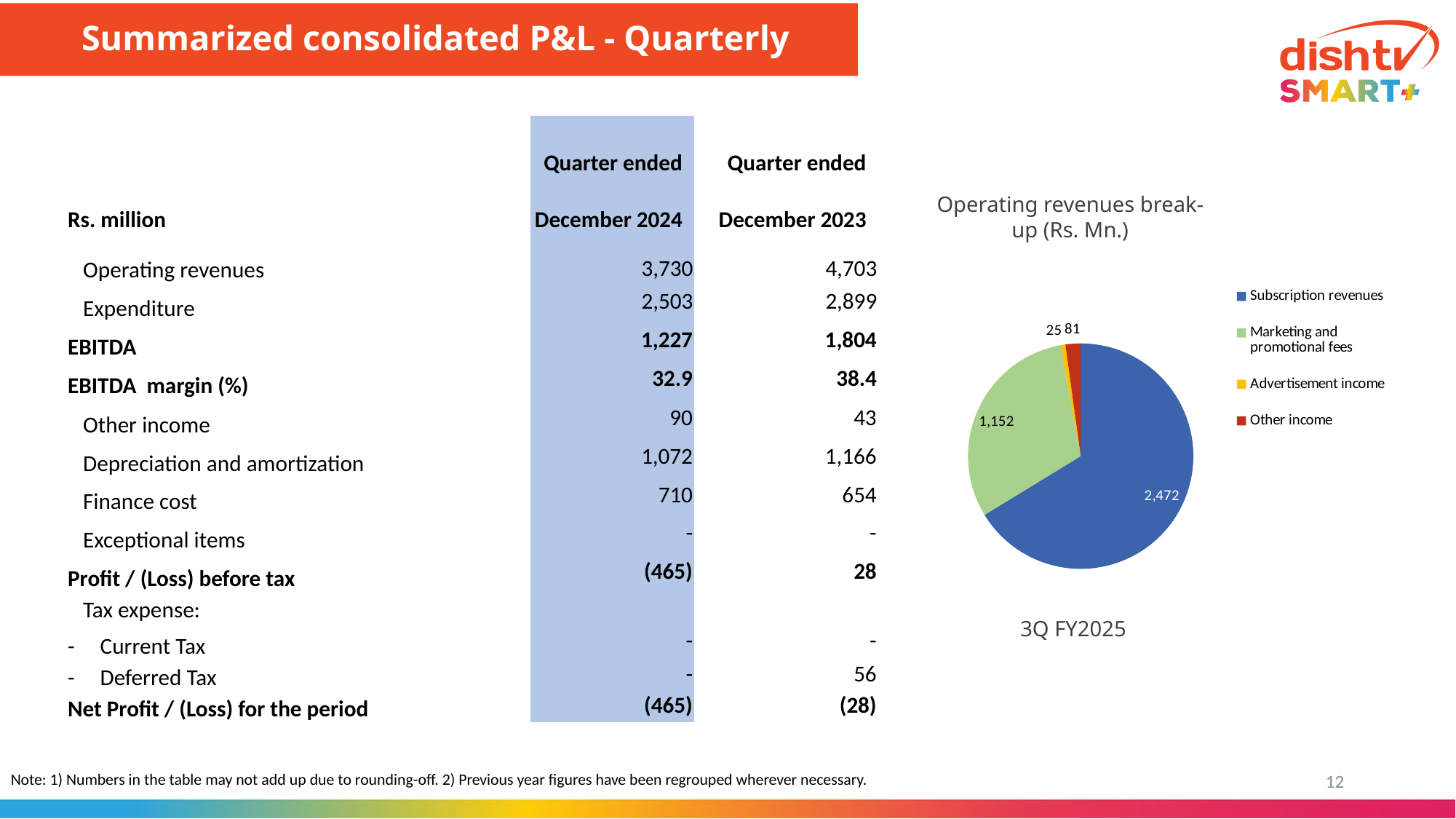
In the operating revenues break-up pie chart, what is the value for Other income? 81 How many categories does the legend of the operating revenues break-up pie chart list? 4 In the operating revenues break-up pie chart, what is the value for Subscription revenues? 2,472 Which category has the largest slice in the operating revenues break-up pie chart? Subscription revenues Which period label appears below the operating revenues break-up pie chart? 3Q FY2025 In the operating revenues break-up pie chart, how much larger is Subscription revenues than Marketing and promotional fees? 1,320 In the operating revenues break-up pie chart, what is the value for Marketing and promotional fees? 1,152 What kind of chart is the "Operating revenues break-up (Rs. Mn.)" chart? pie chart In the operating revenues break-up pie chart, what is the value for Advertisement income? 25 Which category has the smallest slice in the operating revenues break-up pie chart? Advertisement income In the operating revenues break-up pie chart, which is larger: Other income or Advertisement income? Other income What is the total of all slices in the operating revenues break-up pie chart? 3,730